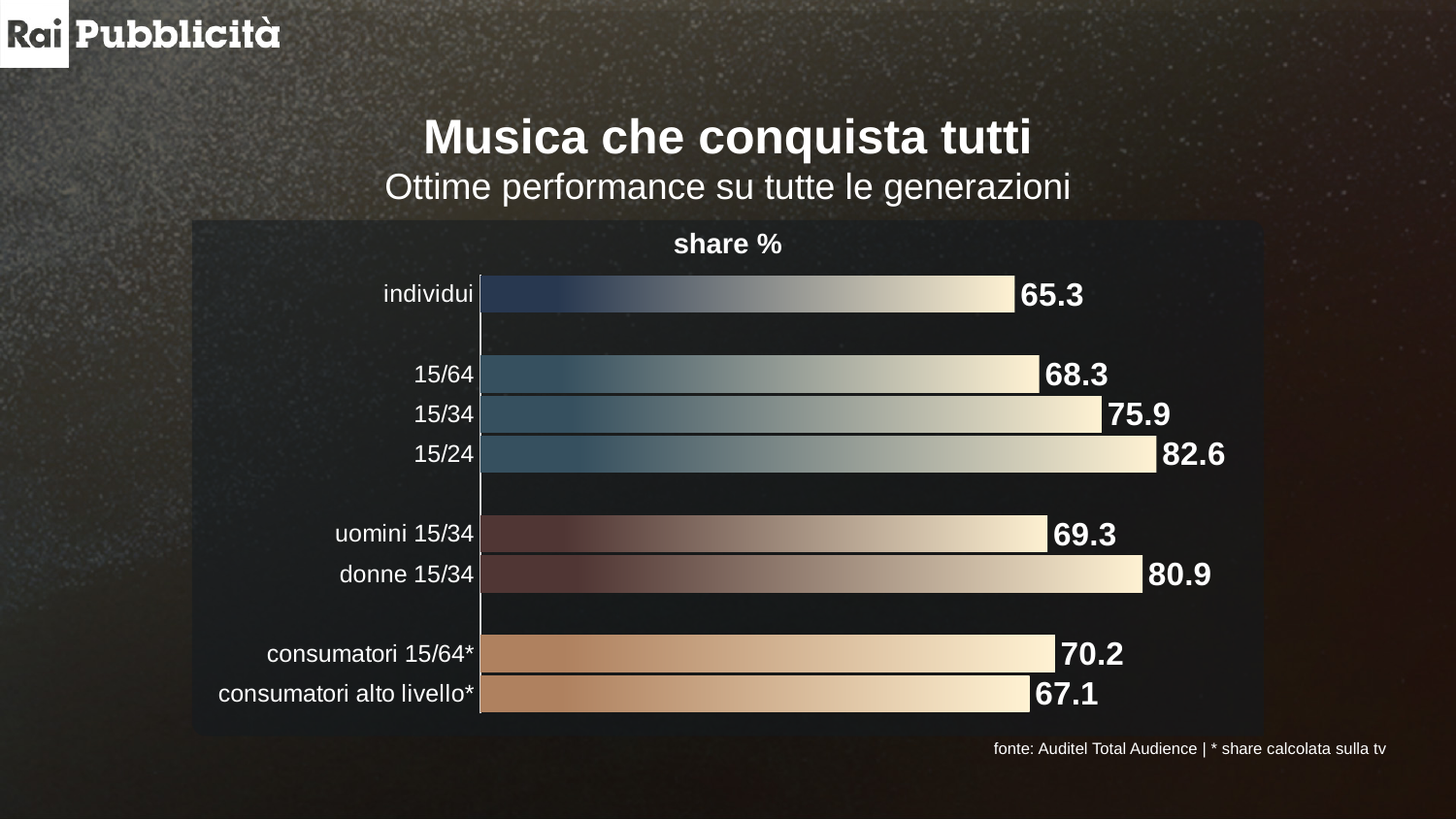
What is the difference in share % between 15/24 and 15/64? 14.3 Which category has the highest share %? 15/24 Which category has the lowest share %? individui What is the title of the chart? share % How many categories are plotted in the chart? 8 What type of chart is shown on the slide? bar chart What is the share % for the 15/24 category? 82.6 What is the share % for consumatori alto livello*? 67.1 What is the difference in share % between donne 15/34 and uomini 15/34? 11.6 What is the share % for individui? 65.3 Which has a higher share %, consumatori 15/64* or consumatori alto livello*? consumatori 15/64* What is the share % for donne 15/34? 80.9